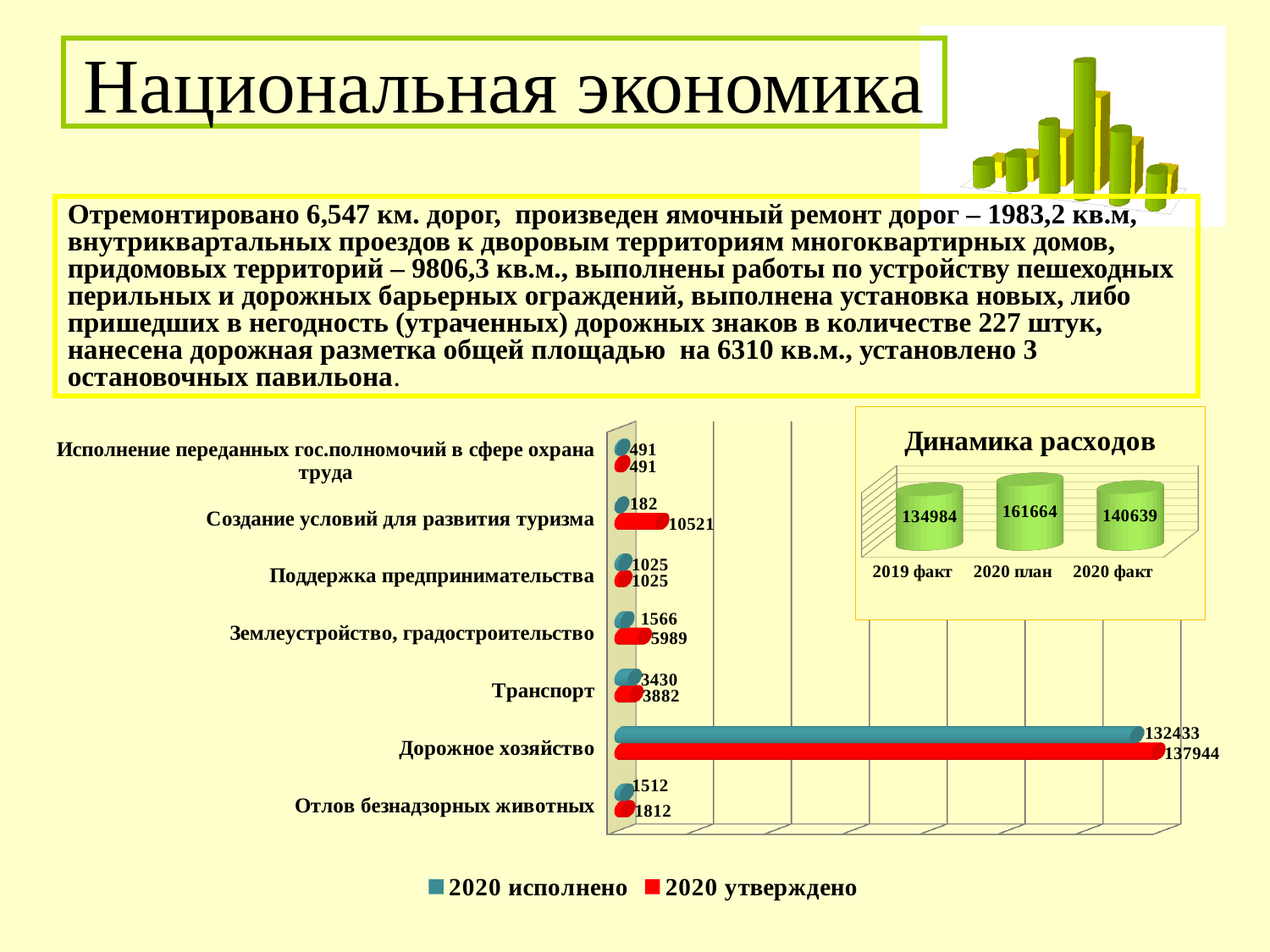
In the bottom bar chart, what is the 2020 исполнено value for Дорожное хозяйство? 132433 In the bottom bar chart, for Транспорт, which is larger: 2020 исполнено or 2020 утверждено? 2020 утверждено In the 'Динамика расходов' chart, what is the value for 2020 план? 161664 In the 'Динамика расходов' chart, which category has the highest value? 2020 план How many series does the legend of the bottom bar chart list? 2 In the bottom bar chart, what is the 2020 утверждено value for Создание условий для развития туризма? 10521 In the bottom bar chart, what is the difference between the 2020 утверждено and 2020 исполнено values for Дорожное хозяйство? 5511 In the 'Динамика расходов' chart, what is the difference between 2020 план and 2020 факт? 21025 What kind of chart is the bottom chart with the legend '2020 исполнено' and '2020 утверждено'? Bar chart How many categories are shown in the bottom bar chart? 7 In the bottom bar chart, which category has the lowest 2020 исполнено value? Создание условий для развития туризма In the bottom bar chart, which category has the highest 2020 утверждено value? Дорожное хозяйство